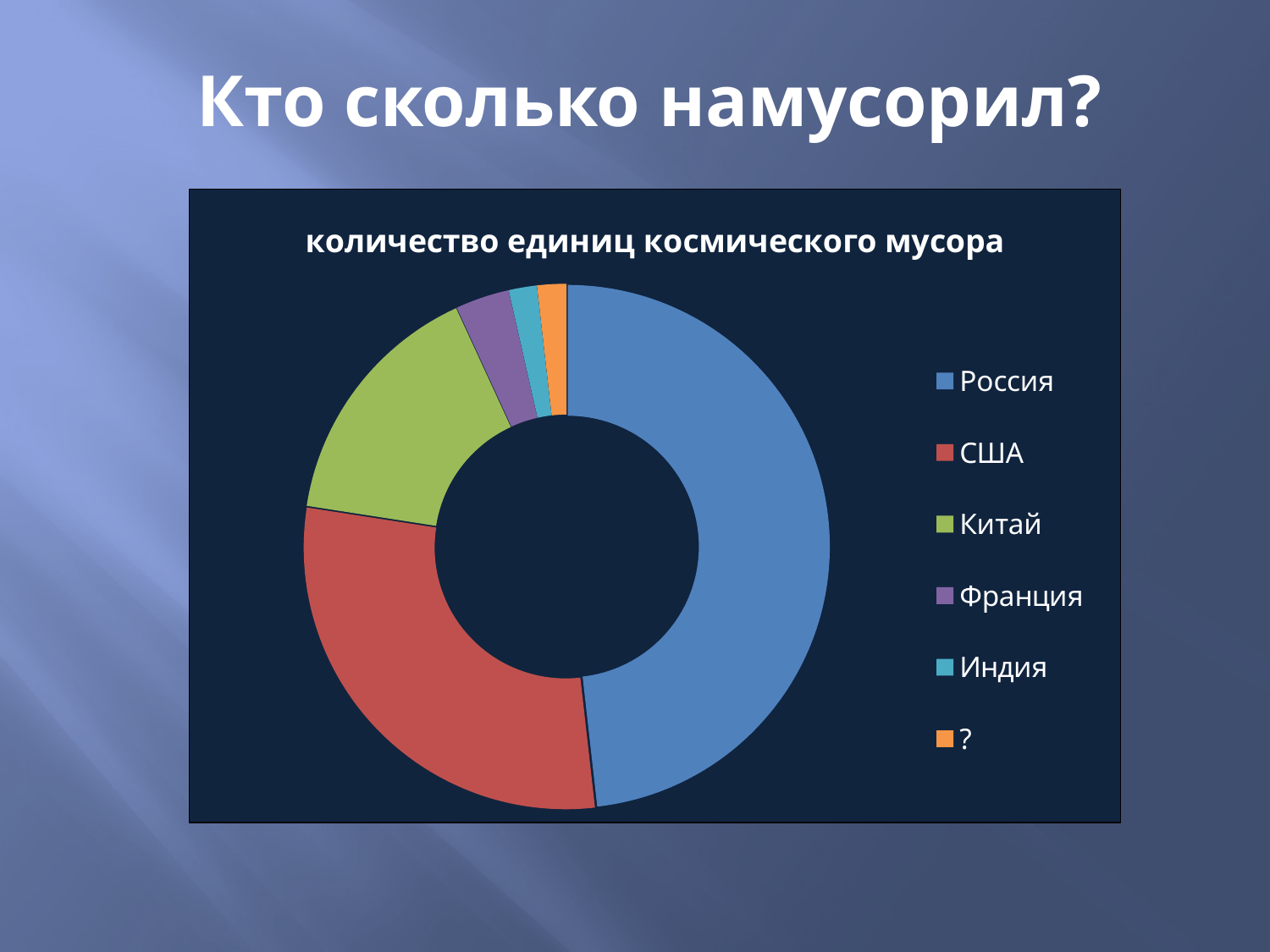
What is the title of the chart? количество единиц космического мусора What colour is the slice for Китай? green Which category has the largest slice of the chart? Россия Which slice is larger, Россия or США? Россия What kind of chart is shown on the slide? doughnut (pie) chart How many categories does the chart's legend list? 6 Which slice is larger, США or Китай? США Which slice is larger, Китай or Франция? Китай Which category has the second-largest slice of the chart? США